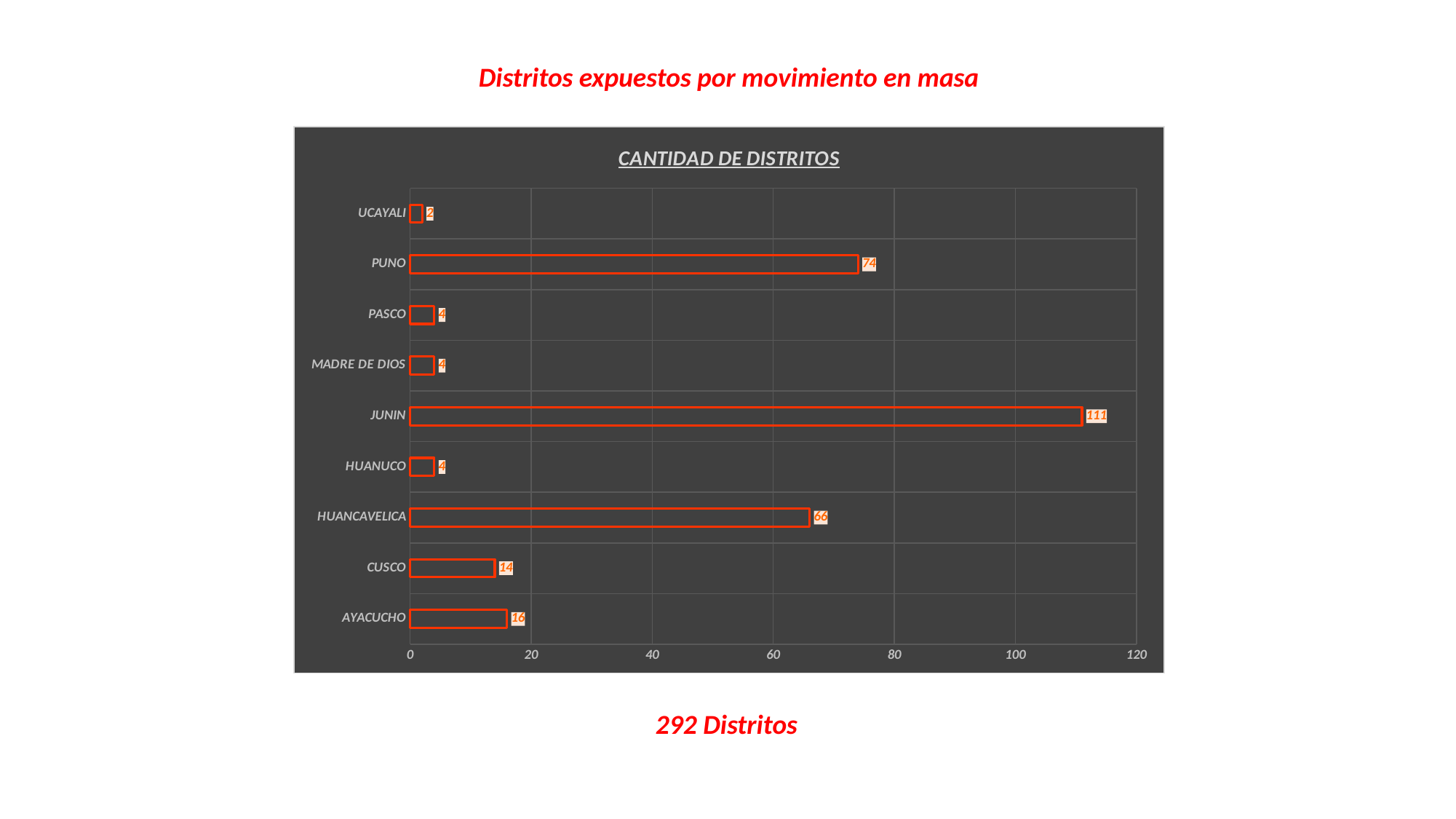
What is the value for PUNO? 74 Which category has the highest value? JUNIN Is the value for HUANCAVELICA greater or less than 60? greater What kind of chart is shown? bar chart How many categories are shown on the chart? 9 What is the difference between the values for JUNIN and PUNO? 37 What is the title of the chart? CANTIDAD DE DISTRITOS Which category has the lowest value? UCAYALI What is the value for AYACUCHO? 16 Which is larger, the value for CUSCO or the value for AYACUCHO? AYACUCHO What is the value for JUNIN? 111 What is the value for HUANCAVELICA? 66